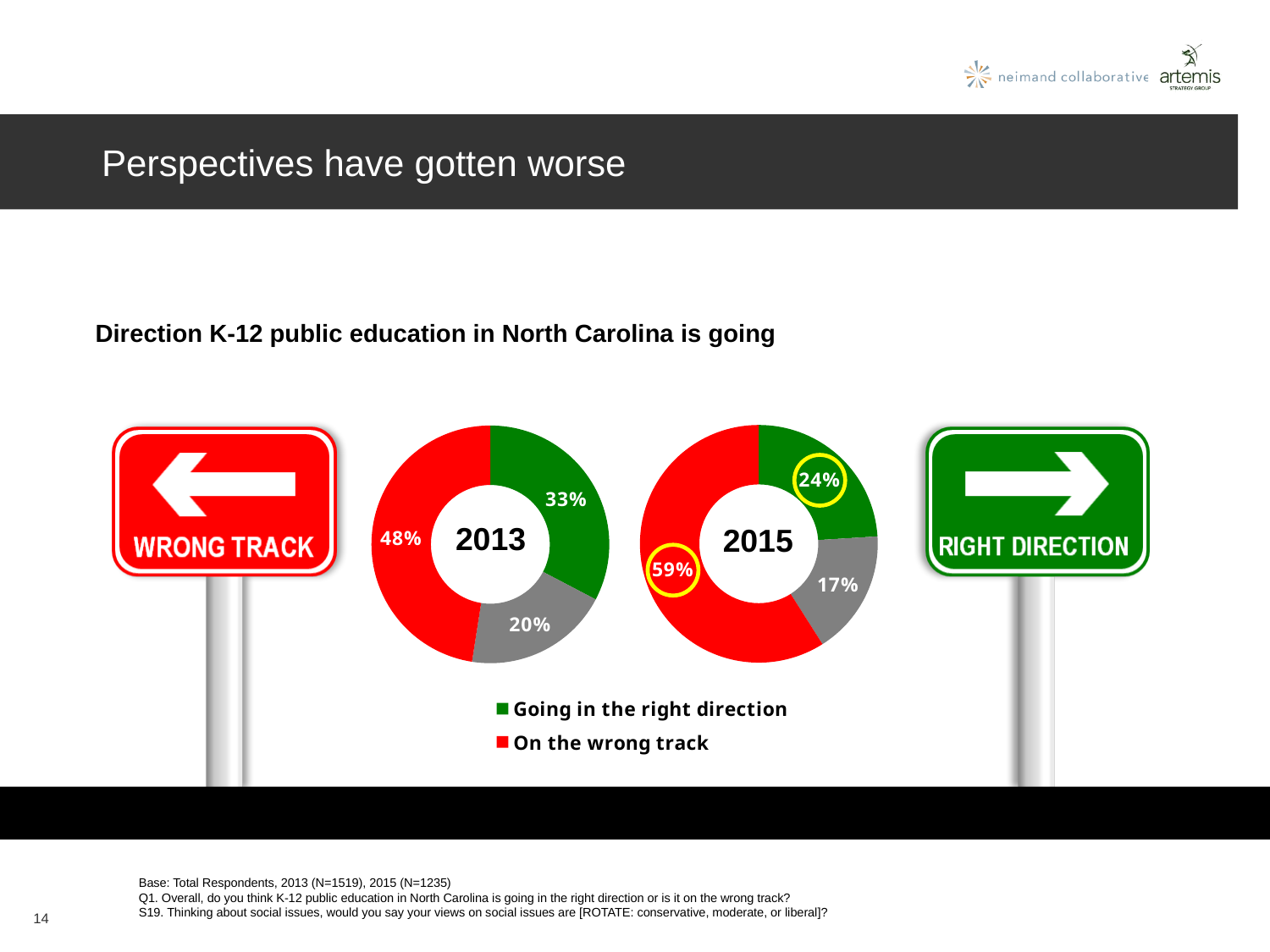
In the 2015 donut chart, which slice is the smallest? The gray slice (17%) In the 2015 donut chart, what is the value of the gray slice? 17% In the 2013 donut chart, which response has the largest share? On the wrong track In the 2013 donut chart, what percentage said K-12 public education is going in the right direction? 33% In the 2015 donut chart, what percentage said K-12 public education is on the wrong track? 59% How many slices does each donut chart have? 3 In the 2013 donut chart, what percentage said K-12 public education is on the wrong track? 48% By how many percentage points did the 'On the wrong track' share increase from the 2013 chart to the 2015 chart? 11 percentage points In the 2015 donut chart, what percentage said K-12 public education is going in the right direction? 24% Which is larger: the 'Going in the right direction' share in 2013 or in 2015? 2013 How many entries does the legend list? 2 What type of chart is used to show the 2013 and 2015 results? Donut (pie) chart